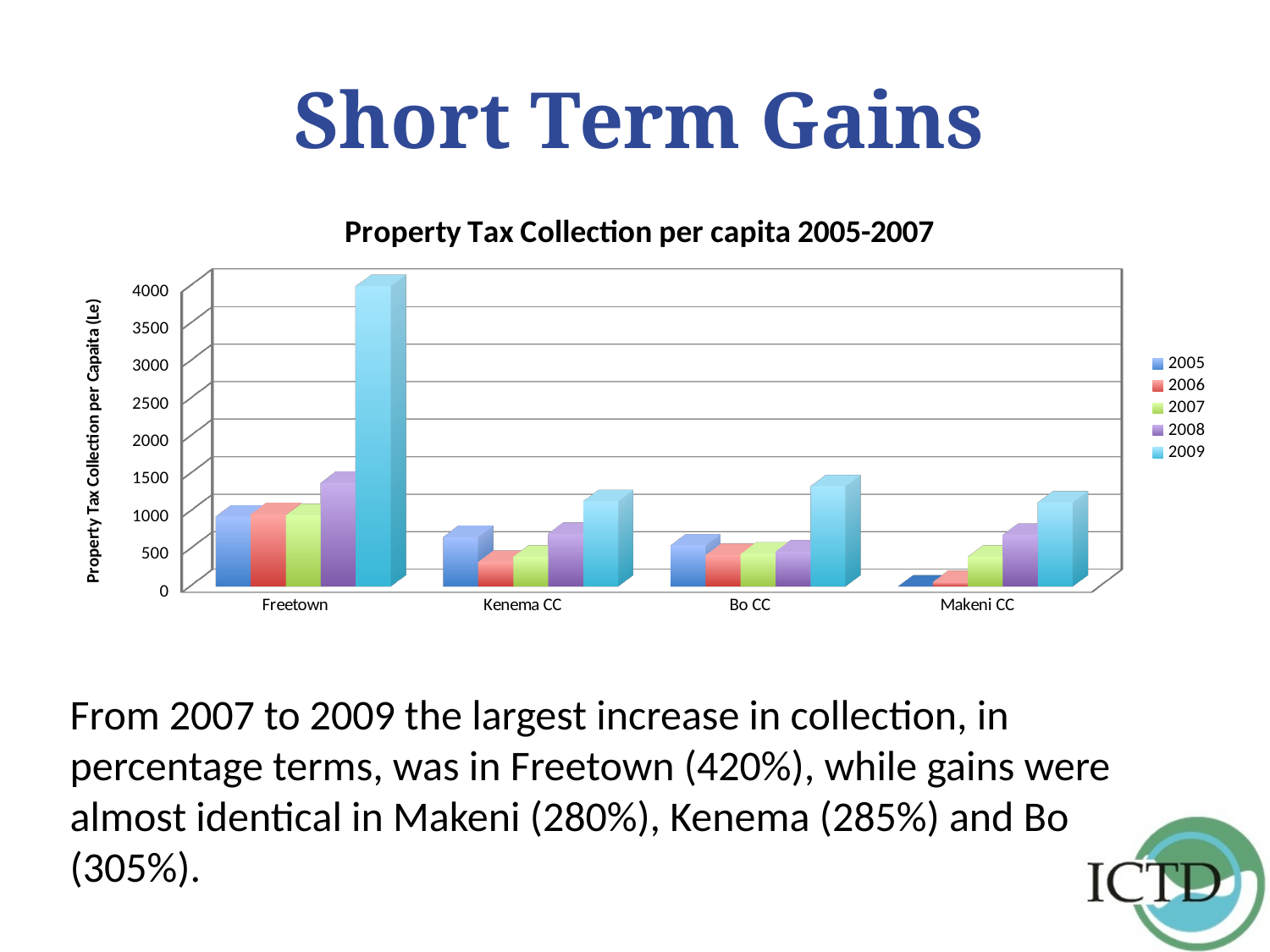
What is the label of the vertical axis? Property Tax Collection per Capaita (Le) What is the title of the chart? Property Tax Collection per capita 2005-2007 Which council has the lowest 2005 property tax collection per capita? Makeni CC Which is larger, the 2009 value for Freetown or the 2009 value for Bo CC? Freetown Which council has the highest 2009 property tax collection per capita? Freetown Is the 2005 value for Makeni CC greater or less than 500? less What type of chart is shown on the slide? Bar chart Is the 2009 value for Freetown greater or less than 3500? greater Is the 2009 value for Bo CC greater or less than 1000? greater How many councils (categories) are shown on the x axis? 4 How many series does the legend list? 5